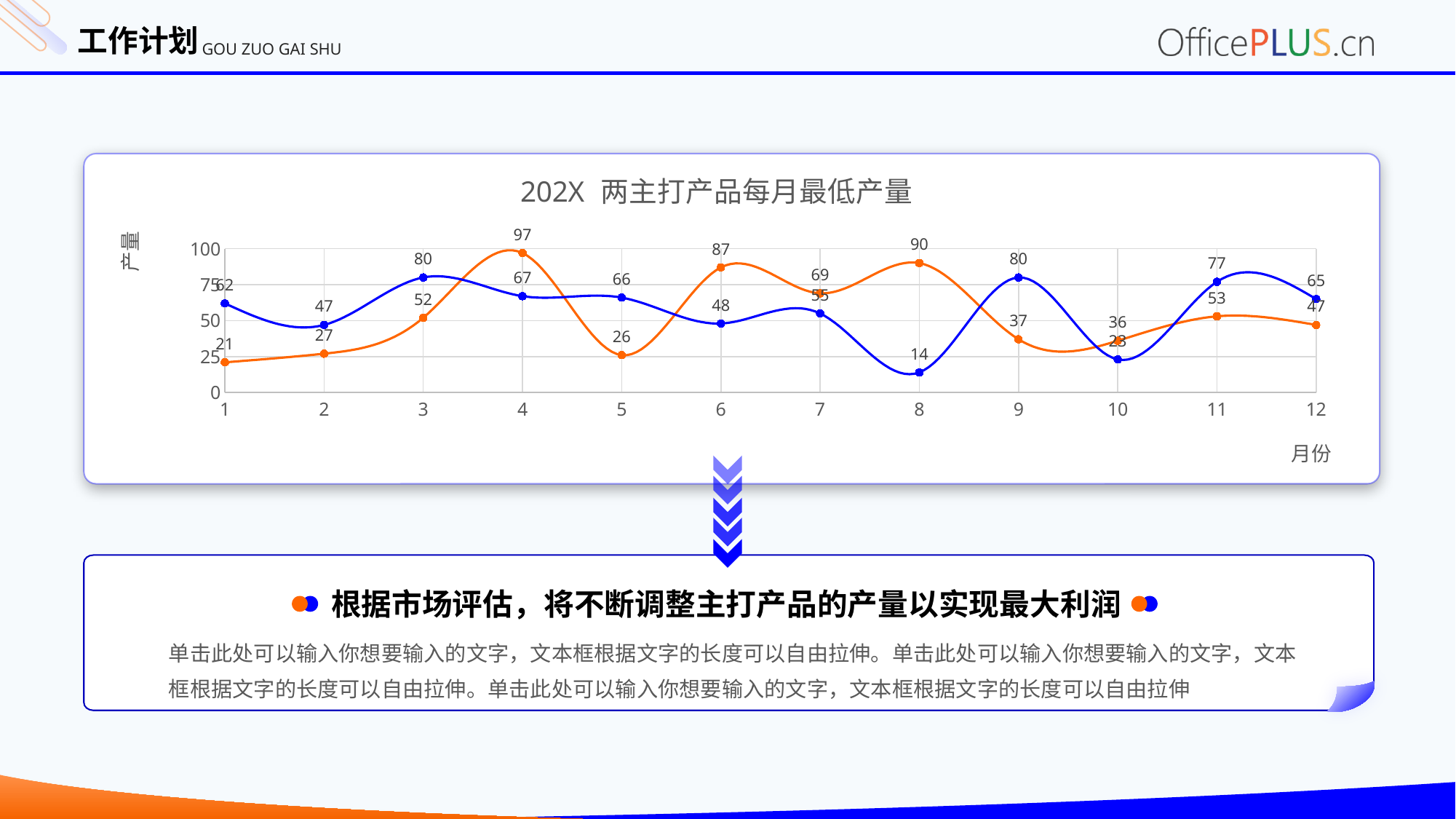
Is the value of the orange line at month 5 greater or less than 50? less What type of chart is shown on the slide? line chart At which month does the blue line reach its lowest value? 8 What is the value of the blue line at month 8? 14 What is the value of the orange line at month 4? 97 What is the title of the chart? 202X 两主打产品每月最低产量 How many months are plotted along the x axis of the chart? 12 At month 3, which line has the higher value, the blue line or the orange line? blue line What is the value of the blue line at month 11? 77 What is the difference between the orange line and the blue line at month 8? 76 At which month does the orange line reach its highest value? 4 What is the value of the orange line at month 6? 87